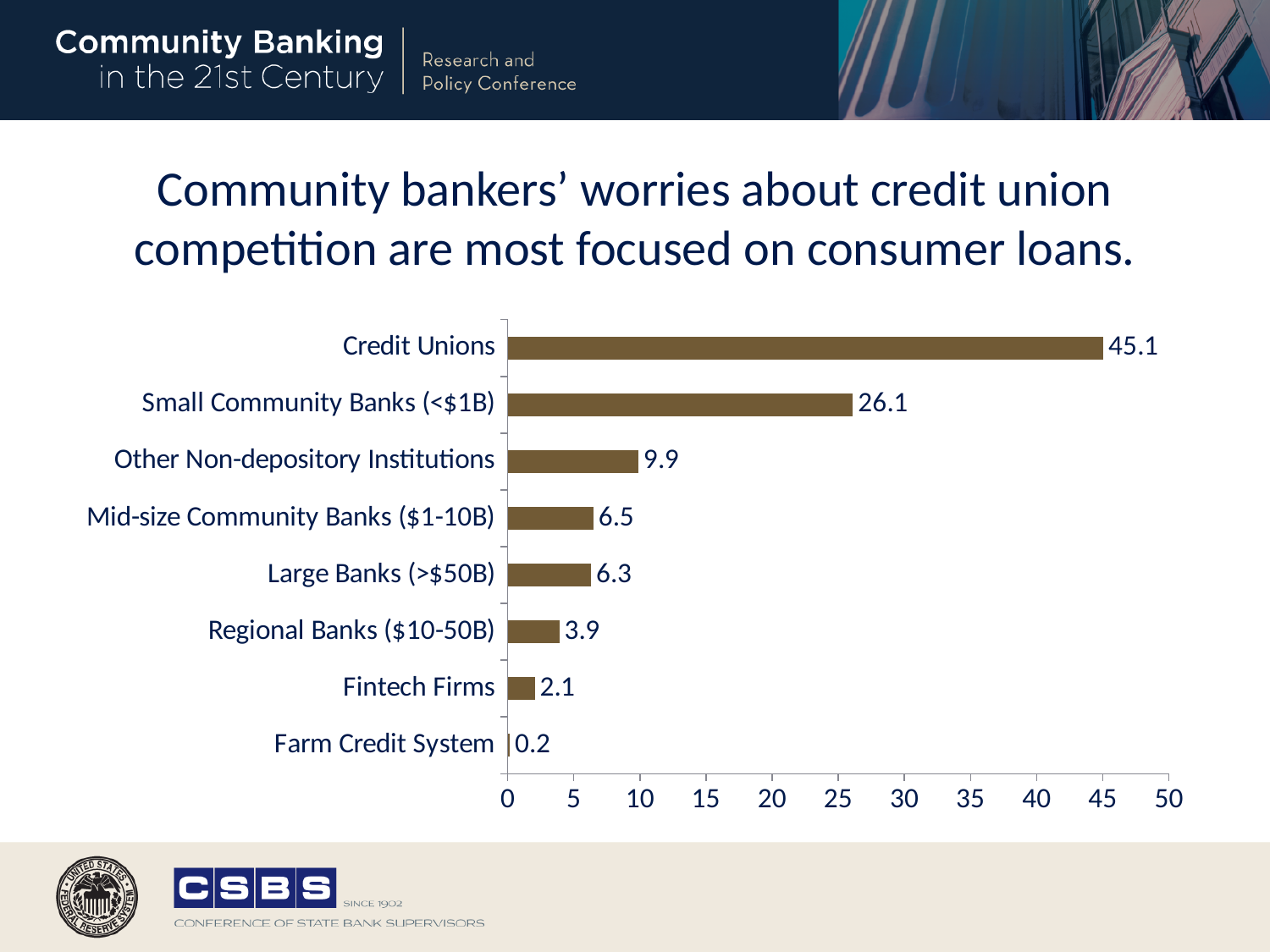
What is the difference between the values for Credit Unions and Small Community Banks (<$1B)? 19 What is the value for Fintech Firms? 2.1 Which is larger, the value for Other Non-depository Institutions or the value for Regional Banks ($10-50B)? Other Non-depository Institutions What is the value for Small Community Banks (<$1B)? 26.1 What is the title of the slide? Community bankers' worries about credit union competition are most focused on consumer loans. What is the value for Farm Credit System? 0.2 Is the value for Small Community Banks (<$1B) greater or less than 25? greater What kind of chart is shown on the slide? bar chart How many categories are shown in the chart? 8 What is the value for Credit Unions? 45.1 Which category has the highest value? Credit Unions Which category has the lowest value? Farm Credit System